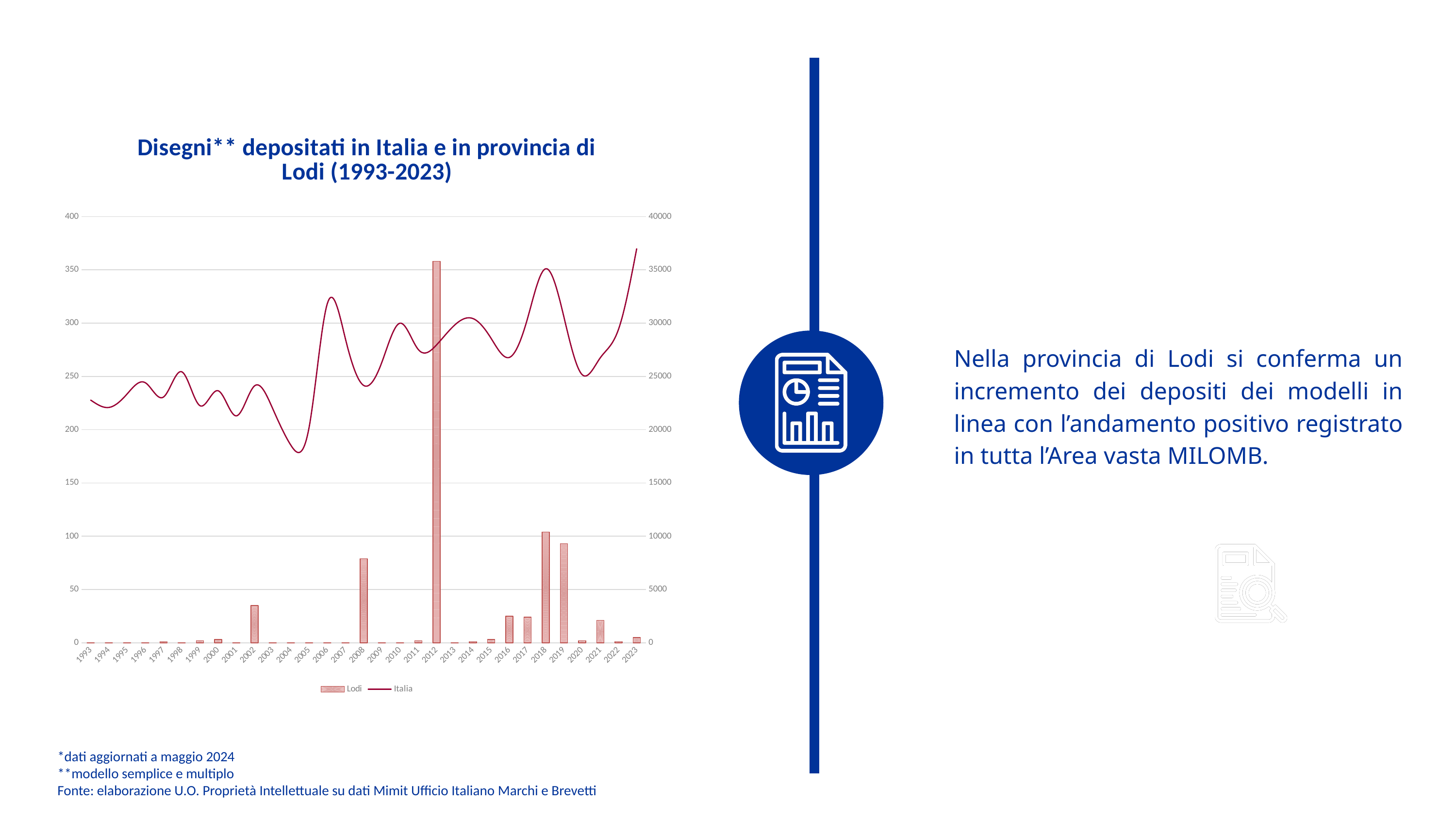
In which year is the Lodi bar highest? 2012 Is the Italia value for 2023 greater or less than 35000? greater How many series does the legend list? 2 Which year has the larger Lodi value, 2008 or 2018? 2018 What kind of chart is shown on the slide? A combination bar and line chart Which year has the larger Italia value, 2018 or 2020? 2018 What are the two series named in the legend? Lodi and Italia In which year does the Italia line reach its highest value? 2023 Is the Lodi value for 2008 greater or less than 50? greater Is the Lodi value for 2012 greater or less than 300? greater How many years are shown on the x axis? 31